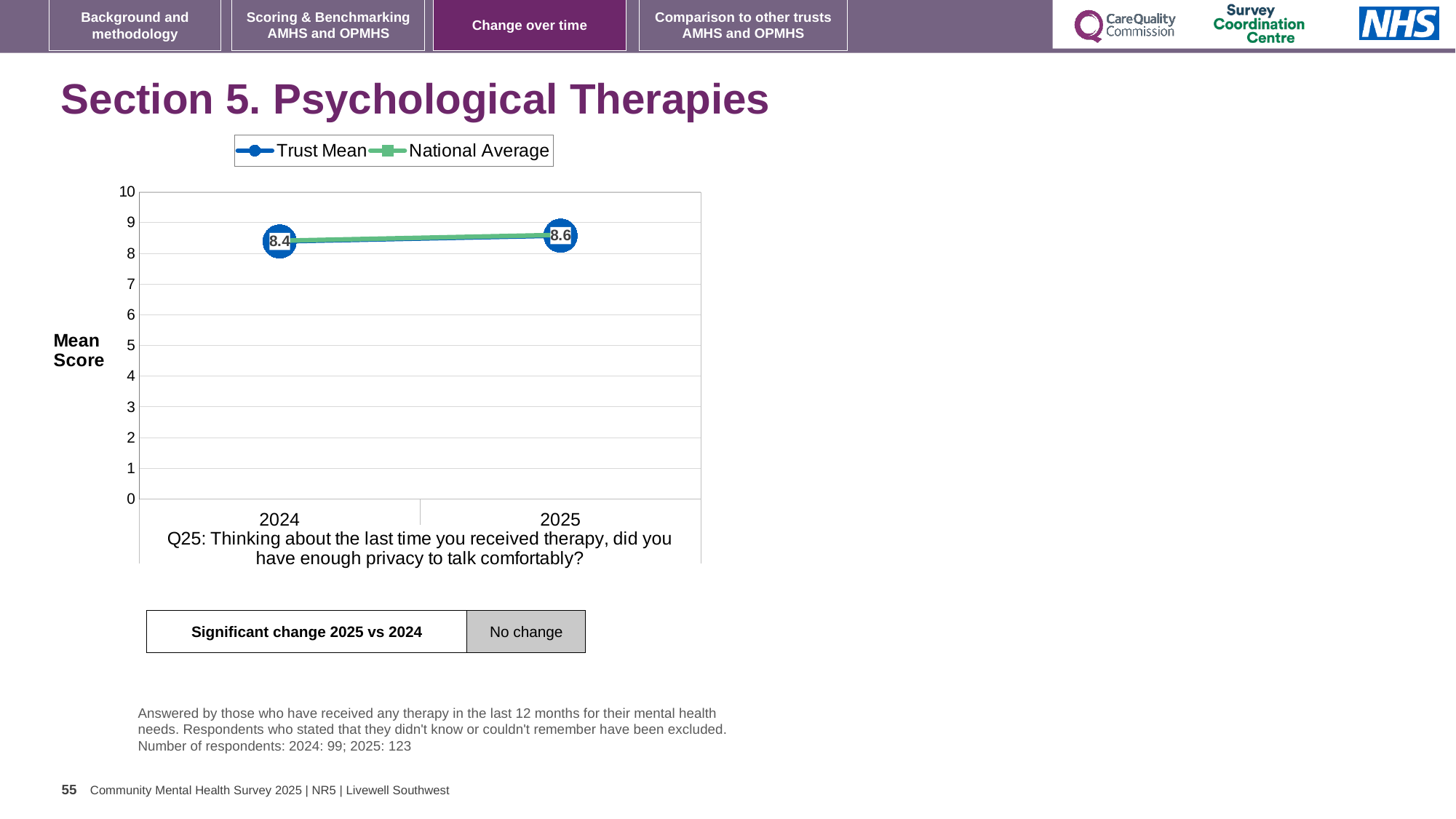
Is the National Average value for 2025 greater or less than 9? less What kind of chart is shown on the slide? line chart Which year has the higher Trust Mean score, 2024 or 2025? 2025 What is the difference between the Trust Mean scores for 2025 and 2024? 0.2 How many series does the legend list? 2 What is the label of the y axis? Mean Score What is the Trust Mean score for 2025? 8.6 Which series is shown in green in the legend? National Average Does the Trust Mean rise or fall from 2024 to 2025? rise What is the Trust Mean score for 2024? 8.4 Is the National Average value for 2024 greater or less than 8? greater How many years are plotted on the x axis? 2